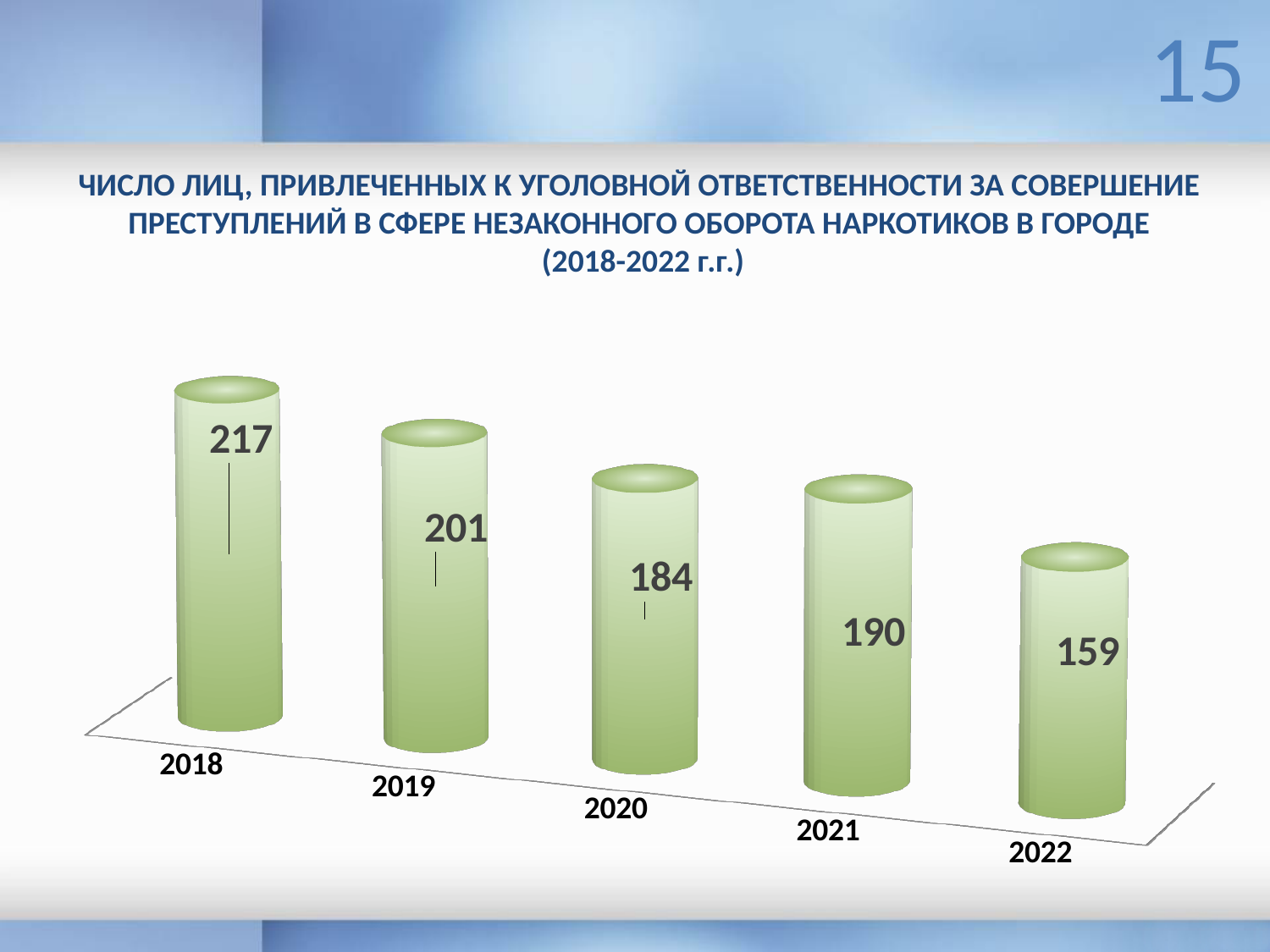
What is the value for 2021? 190 What is the difference between the values for 2018 and 2022? 58 What is the value for 2022? 159 What is the value for 2018? 217 Which is larger, the value for 2020 or the value for 2021? 2021 Which year has the highest value? 2018 Do the values generally rise or fall from 2018 to 2022? fall Which year has the lowest value? 2022 What kind of chart is shown on the slide? bar chart What is the difference between the values for 2019 and 2020? 17 How many years are shown on the chart? 5 What is the value for 2020? 184